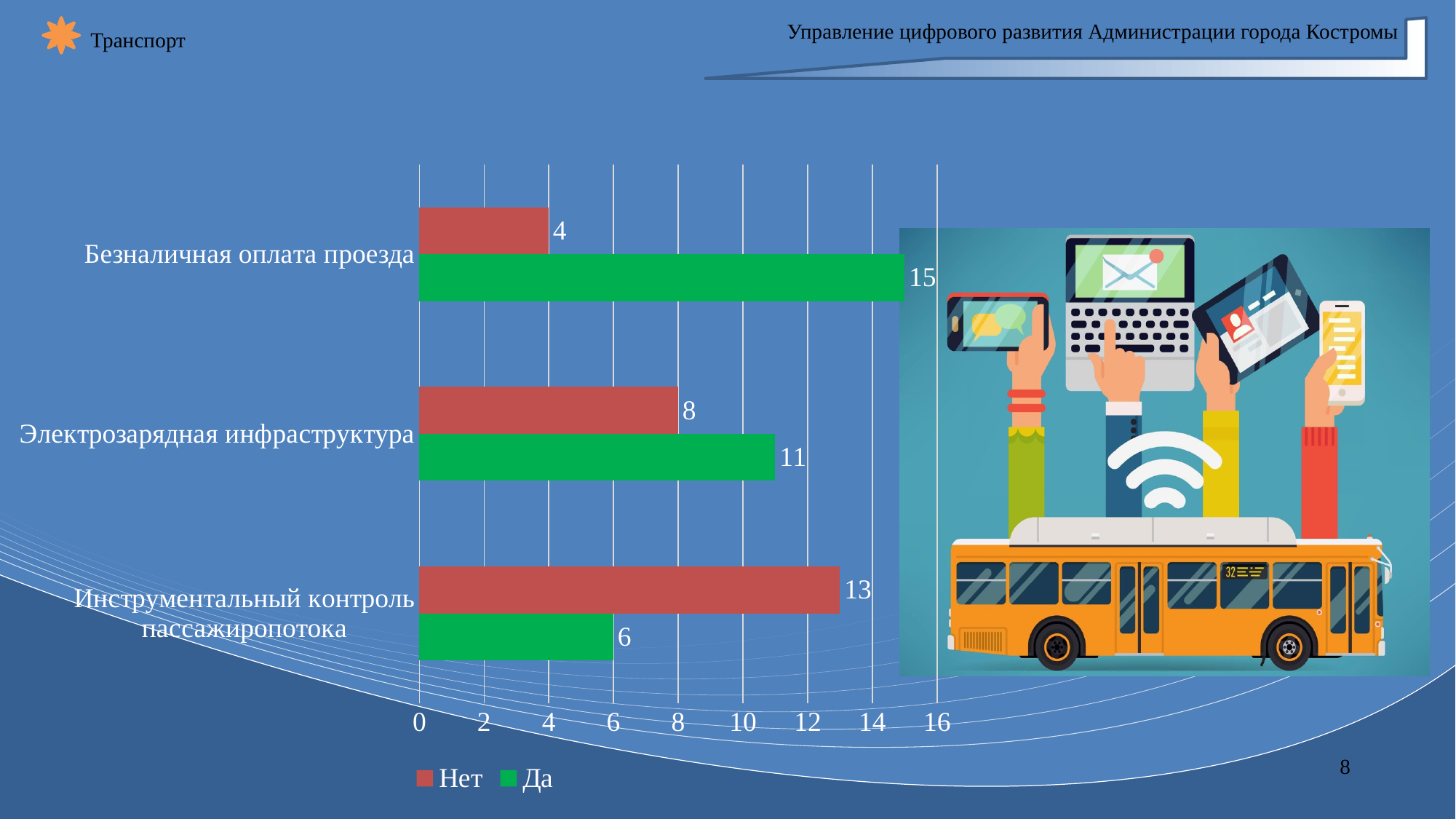
Which category has the highest "Нет" value? Инструментальный контроль пассажиропотока What is the total of "Да" and "Нет" for "Инструментальный контроль пассажиропотока"? 19 Which category has the lowest "Да" value? Инструментальный контроль пассажиропотока What is the value of "Да" for "Инструментальный контроль пассажиропотока"? 6 What is the value of "Нет" for "Электрозарядная инфраструктура"? 8 How many series does the legend list? 2 What is the value of "Да" for "Безналичная оплата проезда"? 15 What kind of chart is shown on the slide? Bar chart How many categories are shown on the chart? 3 Which is larger for "Электрозарядная инфраструктура": "Да" or "Нет"? Да Which colour represents the "Нет" series in the legend? Red What is the difference between the "Да" and "Нет" values for "Безналичная оплата проезда"? 11